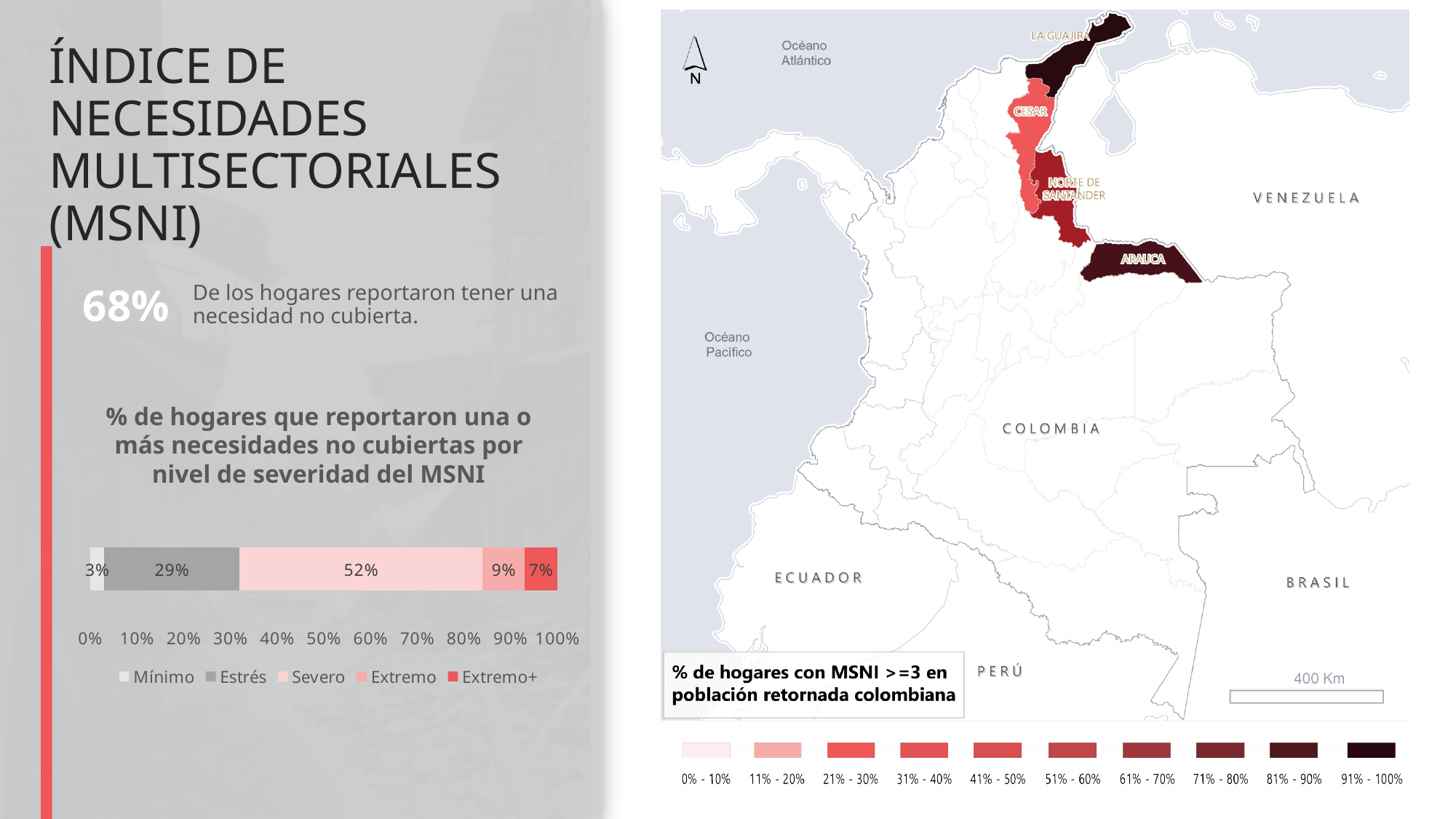
In the stacked bar chart, what is the total of all five segments? 100% In the stacked bar chart, which segment is larger, Extremo or Extremo+? Extremo In the stacked bar chart, what percentage of households is in the Estrés level? 29% In the stacked bar chart, which severity level has the smallest share of households? Mínimo What is the title of the stacked bar chart on the left of the slide? % de hogares que reportaron una o más necesidades no cubiertas por nivel de severidad del MSNI How many series does the legend of the stacked bar chart list? 5 In the stacked bar chart, what percentage of households is in the Extremo+ level? 7% In the stacked bar chart, what is the difference in percentage points between the Severo and Estrés segments? 23 percentage points In the stacked bar chart, which severity level has the largest share of households? Severo What kind of chart is used to show the percentage of households by MSNI severity level? Stacked bar chart In the stacked bar chart, what percentage of households is in the Mínimo level? 3% In the stacked bar chart, what percentage of households is in the Severo level? 52%